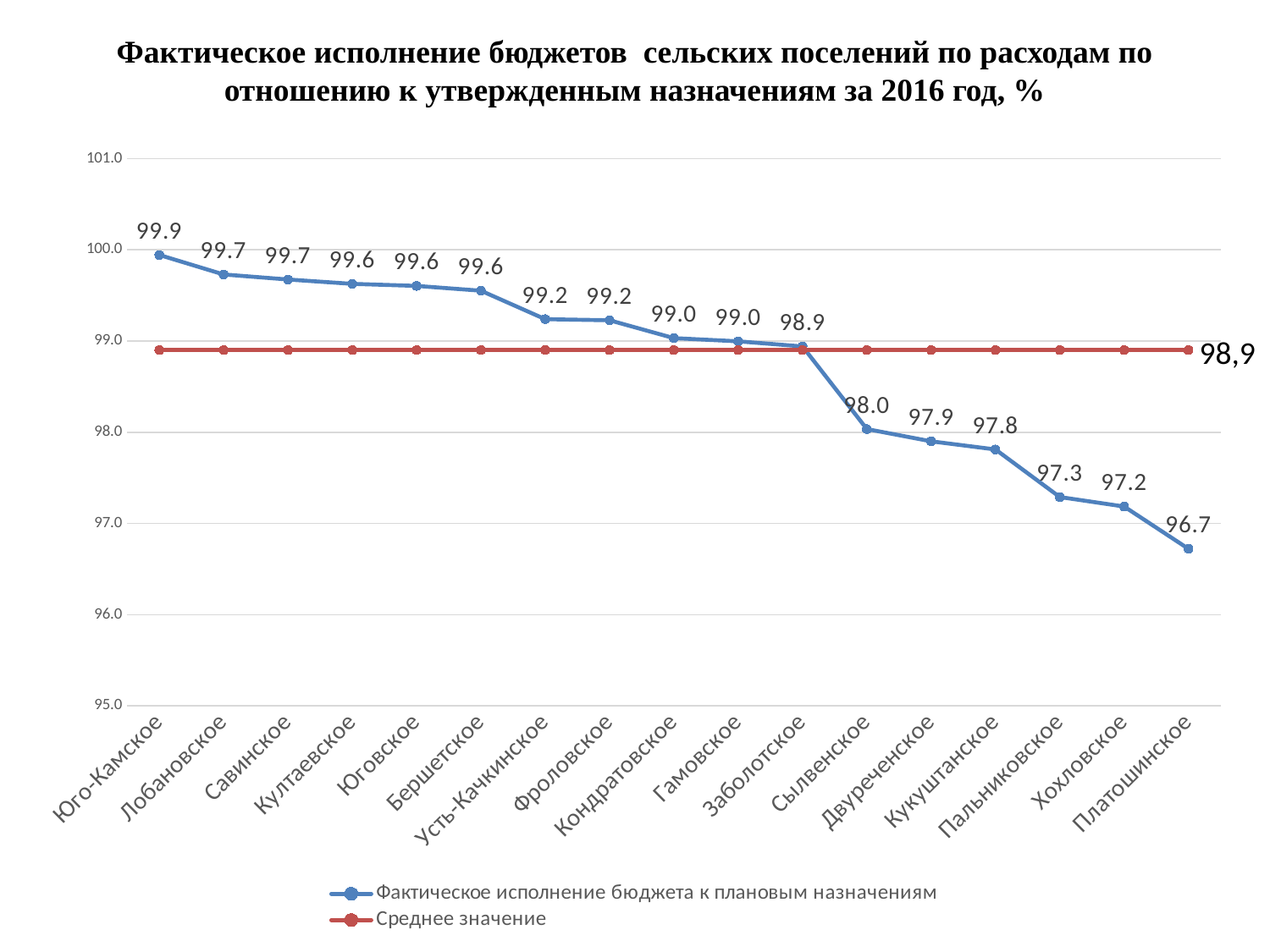
What is the value for Пальниковское? 97.3 Which settlement has the highest value? Юго-Камское Which settlement has the lowest value? Платошинское What is the value for Юго-Камское? 99.9 What is the value for Сылвенское? 98.0 Is the value for Двуреченское greater or less than 98.0? less How many series does the legend list? 2 How many settlements are shown on the x axis? 17 What is the difference between the values for Юго-Камское and Платошинское? 3.2 What is the value of the average line (Среднее значение)? 98,9 Which is larger, the value for Кукуштанское or the value for Хохловское? Кукуштанское What kind of chart is this? line chart